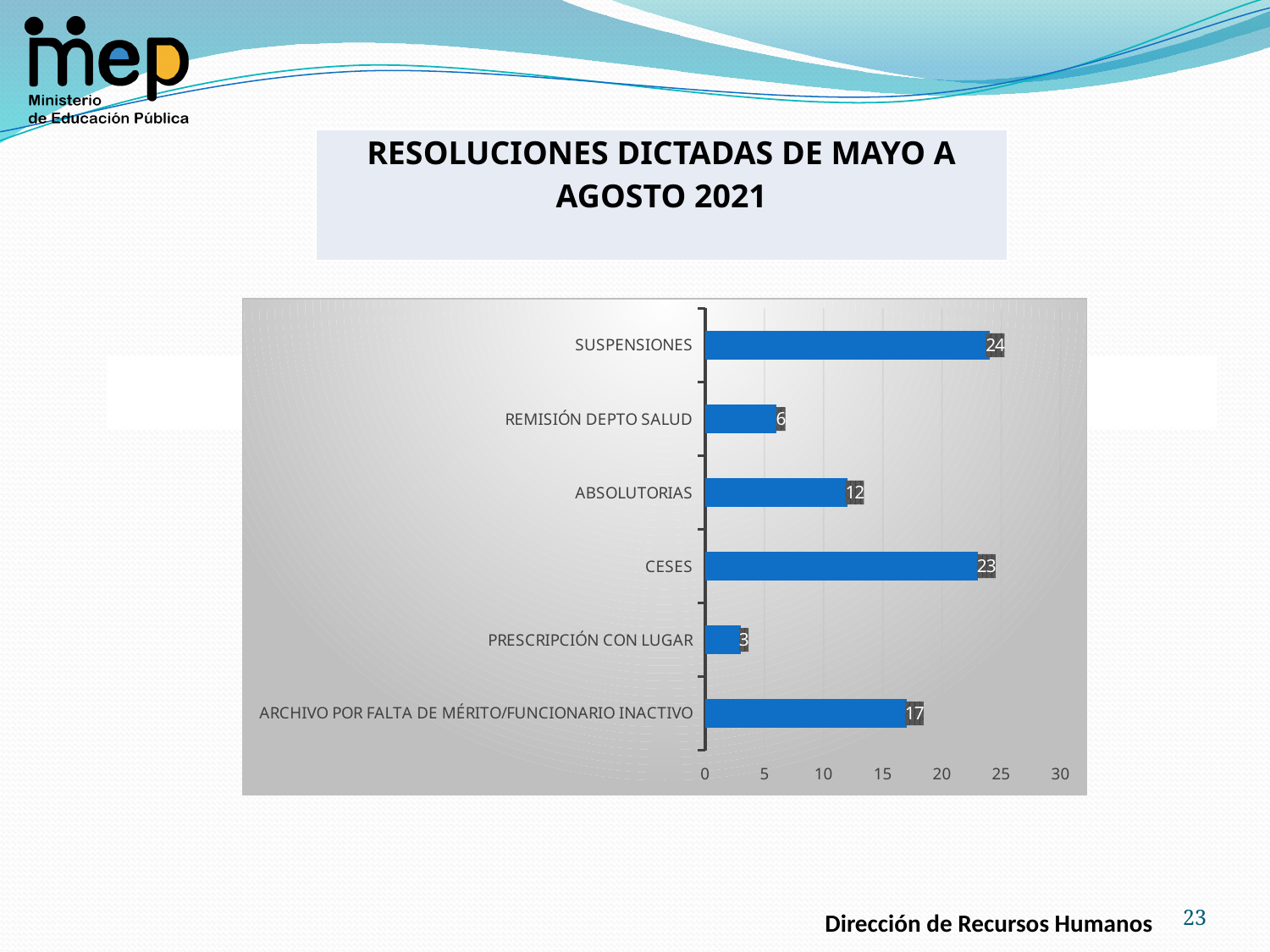
What is the value for CESES? 23 How many categories are shown in the chart? 6 Which is larger, the value for ABSOLUTORIAS or the value for ARCHIVO POR FALTA DE MÉRITO/FUNCIONARIO INACTIVO? ARCHIVO POR FALTA DE MÉRITO/FUNCIONARIO INACTIVO What is the value for ARCHIVO POR FALTA DE MÉRITO/FUNCIONARIO INACTIVO? 17 What is the value for ABSOLUTORIAS? 12 What is the value for SUSPENSIONES? 24 Which category has the lowest value? PRESCRIPCIÓN CON LUGAR What is the value for REMISIÓN DEPTO SALUD? 6 What is the title of the chart? RESOLUCIONES DICTADAS DE MAYO A AGOSTO 2021 What kind of chart is shown on the slide? Bar chart What is the difference between the values for SUSPENSIONES and CESES? 1 What is the difference between the values for ABSOLUTORIAS and REMISIÓN DEPTO SALUD? 6